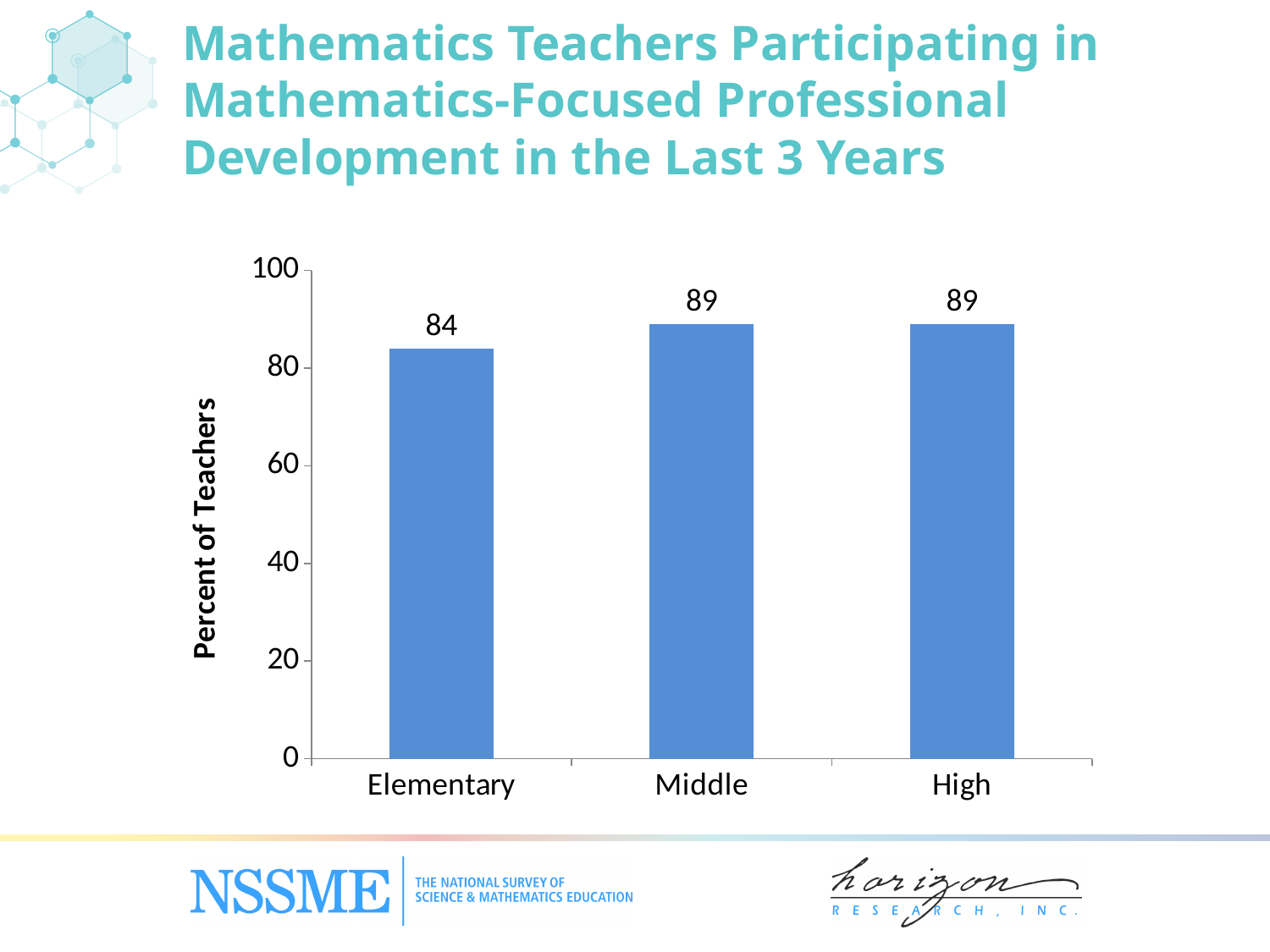
What kind of chart is shown on the slide? Bar chart What percent of elementary mathematics teachers participated in mathematics-focused professional development in the last 3 years? 84 Which category has the lowest percent of teachers? Elementary What is the value shown for High school teachers? 89 How many categories are shown on the x axis? 3 What is the value shown for Middle school teachers? 89 Which is larger, the value for Elementary or the value for High? High What is the title of the chart? Mathematics Teachers Participating in Mathematics-Focused Professional Development in the Last 3 Years What is the difference between the values for Middle and Elementary? 5 What is the label of the vertical axis? Percent of Teachers Do the values for Middle and High differ? No Is the value for Elementary greater or less than 80? greater